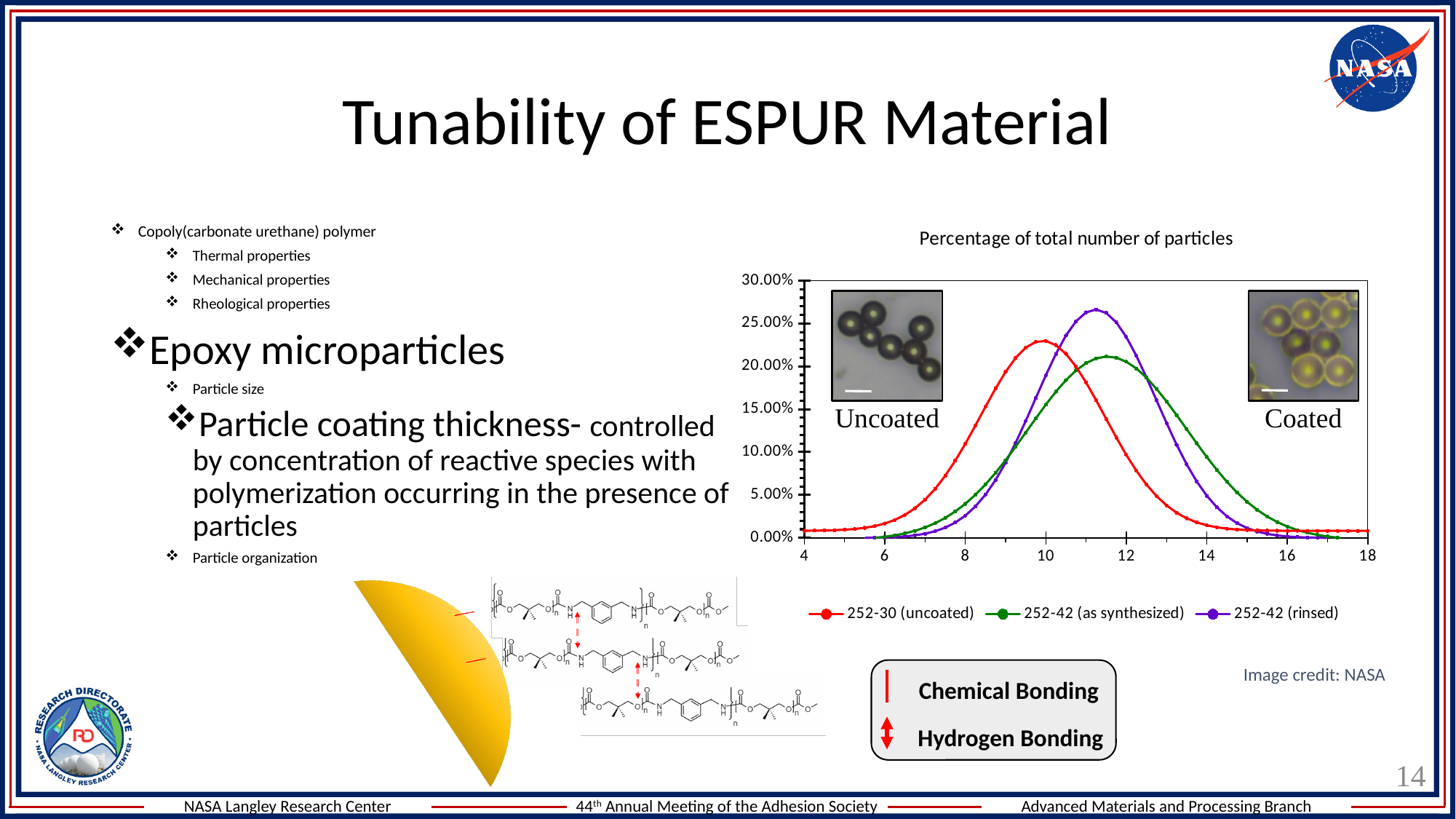
What colour is used for the 252-30 (uncoated) series? red Is the peak value of the 252-30 (uncoated) series greater or less than 20.00%? greater Is the peak value of the 252-42 (rinsed) series greater or less than 25.00%? greater What kind of chart is shown on the slide? line chart Does the 252-30 (uncoated) series rise or fall as x increases from 4 to 10? rise What is the maximum value shown on the chart's y axis? 30.00% Which series has the highest peak value in the chart? 252-42 (rinsed) Is the peak value of the 252-30 (uncoated) series greater or less than 25.00%? less How many series does the chart legend list? 3 Which series reaches its peak at the smallest x-axis value? 252-30 (uncoated) What is the title of the chart? Percentage of total number of particles